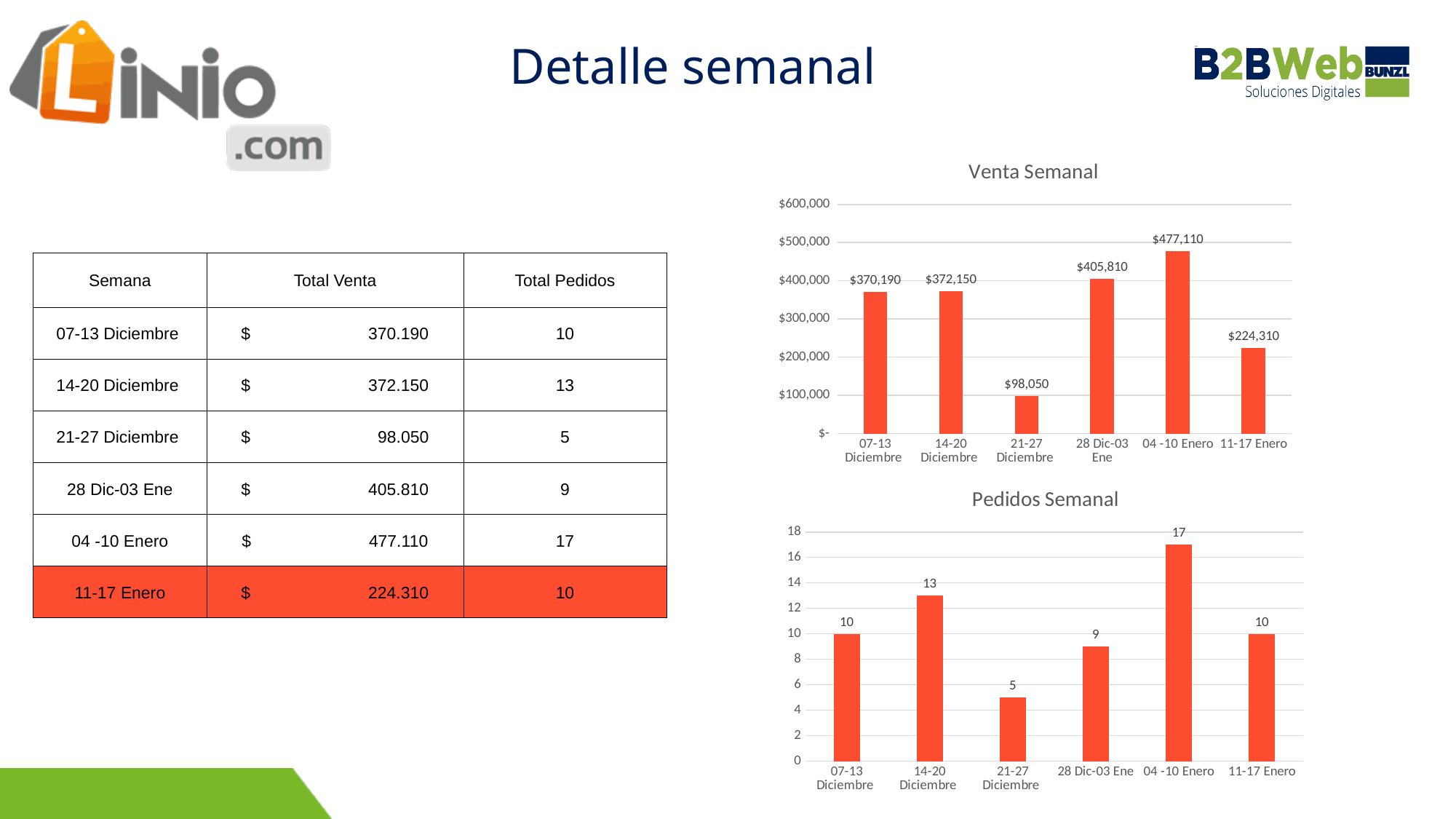
In the Pedidos Semanal chart, what is the value for 14-20 Diciembre? 13 In the Venta Semanal chart, is the value for 21-27 Diciembre greater or less than $100,000? less In the Venta Semanal chart, which week has the highest value? 04 -10 Enero In the Venta Semanal chart, how many weeks are plotted? 6 In the Pedidos Semanal chart, which is larger, 28 Dic-03 Ene or 11-17 Enero? 11-17 Enero In the Venta Semanal chart, what is the value for 04 -10 Enero? $477,110 In the Pedidos Semanal chart, which week has the highest value? 04 -10 Enero In the Venta Semanal chart, what is the difference between 28 Dic-03 Ene and 11-17 Enero? $181,500 In the Venta Semanal chart, which week has the lowest value? 21-27 Diciembre What kind of chart is the Pedidos Semanal chart? bar chart In the Pedidos Semanal chart, which week has the lowest value? 21-27 Diciembre In the Pedidos Semanal chart, what is the difference between 04 -10 Enero and 21-27 Diciembre? 12